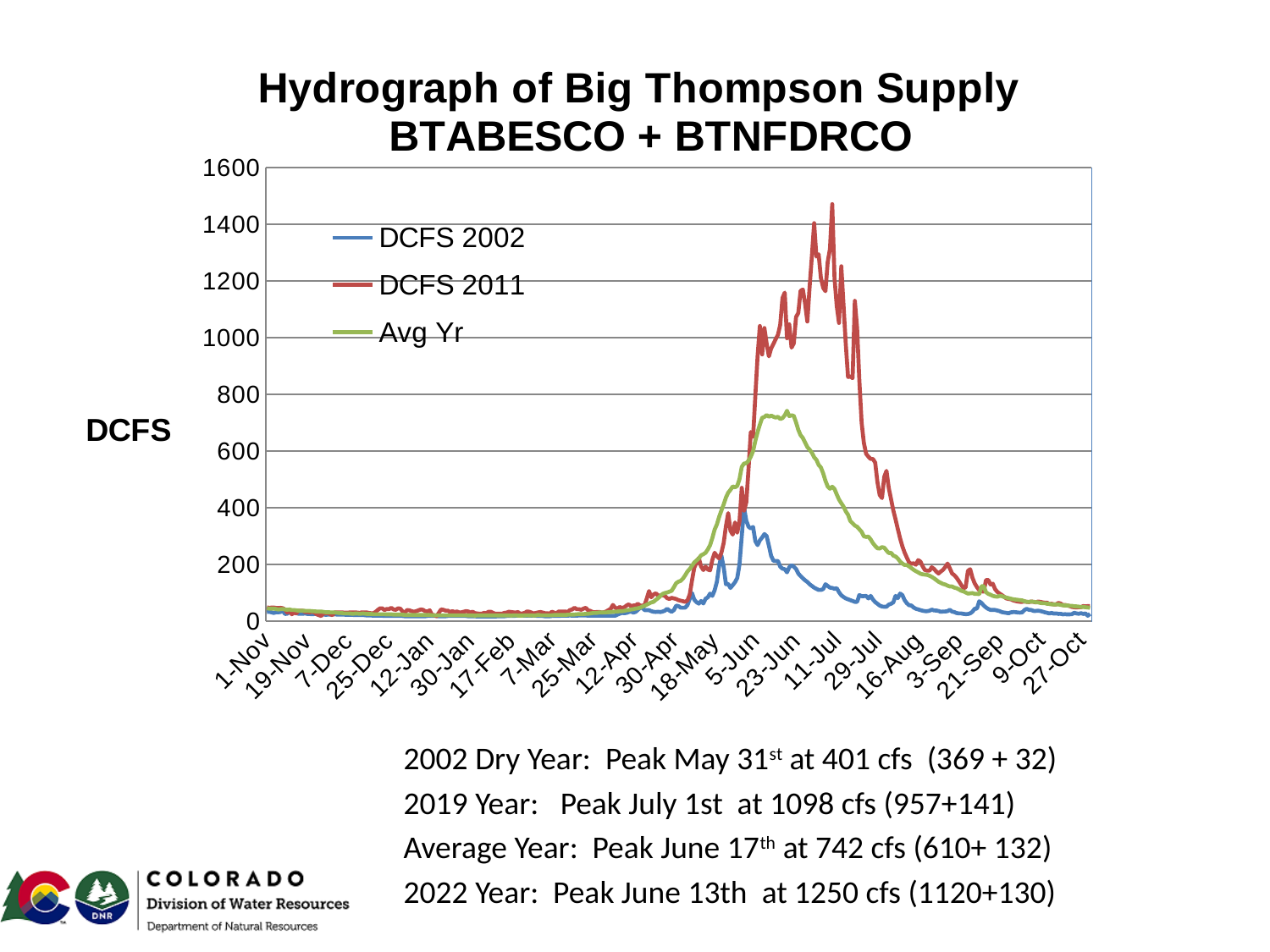
According to the text on the slide, what was the 2002 dry year peak flow in cfs? 401 cfs Which series has the lowest peak value on the chart? DCFS 2002 Is the peak value of the DCFS 2002 series greater or less than 600? less Which series reaches the highest value on the chart? DCFS 2011 Around 23-Jun, which series is higher: Avg Yr or DCFS 2002? Avg Yr Is the peak value of the Avg Yr series greater or less than 600? greater What is the title of the chart? Hydrograph of Big Thompson Supply BTABESCO + BTNFDRCO What are the three series named in the legend? DCFS 2002, DCFS 2011, Avg Yr What kind of chart is shown on the slide? line chart How many series does the legend list? 3 Is the peak value of the DCFS 2011 series greater or less than 1400? greater Around 11-Jul, which series is higher: DCFS 2011 or Avg Yr? DCFS 2011